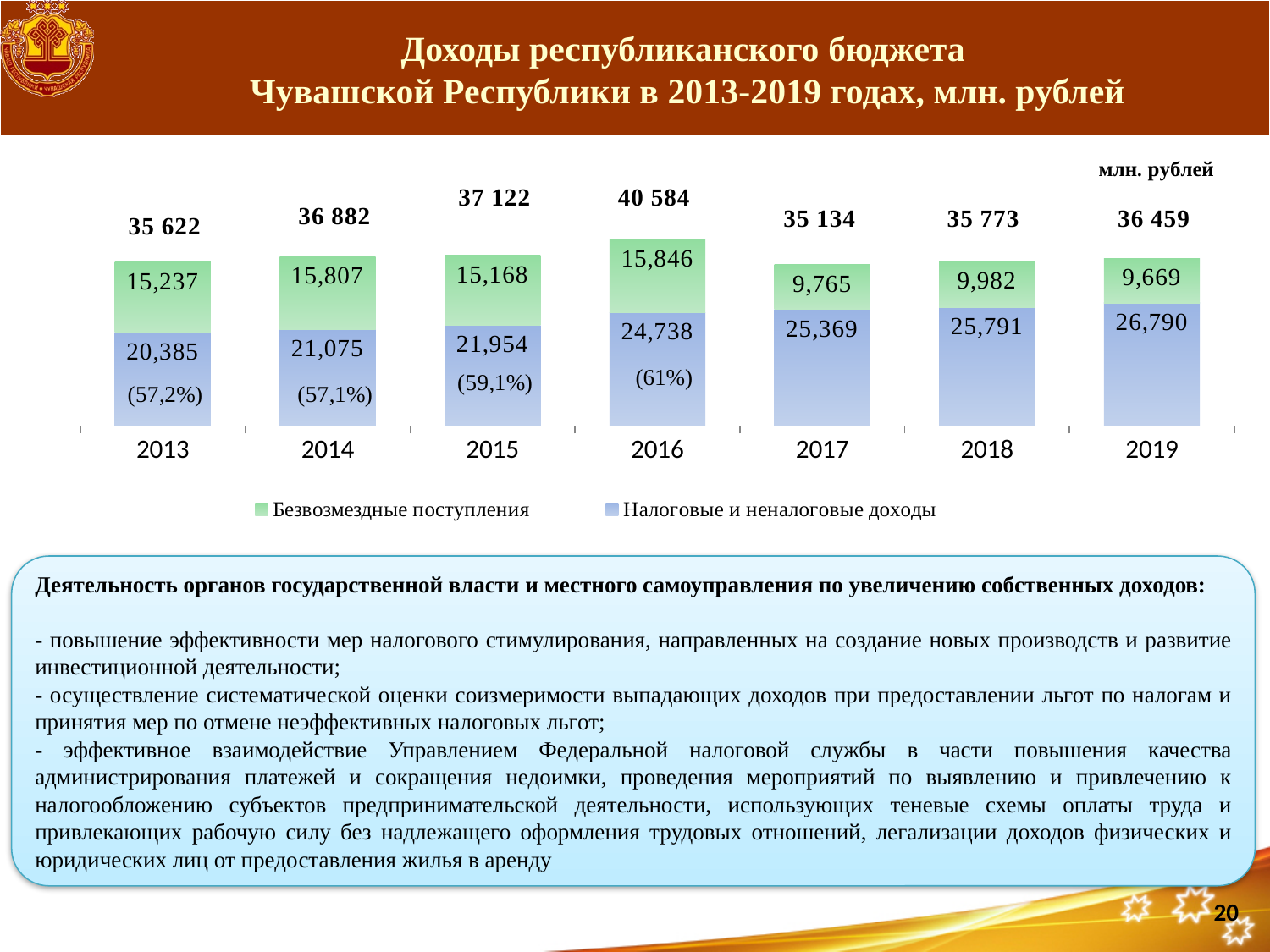
What is the difference between Налоговые и неналоговые доходы in 2019 and in 2013? 6,405 What type of chart is shown on the slide? stacked bar chart Which year has the lowest value of Безвозмездные поступления? 2019 How many years are shown on the x axis? 7 Which year has the lowest total budget revenue? 2017 What is the total printed above the bar for 2016? 40 584 What percentage share is printed for Налоговые и неналоговые доходы in 2015? (59,1%) Which year has the highest total budget revenue? 2016 What is the value of Налоговые и неналоговые доходы for 2016? 24,738 What is the value of Безвозмездные поступления for 2018? 9,982 Is the value of Безвозмездные поступления larger in 2014 or in 2017? 2014 How many series does the legend list? 2